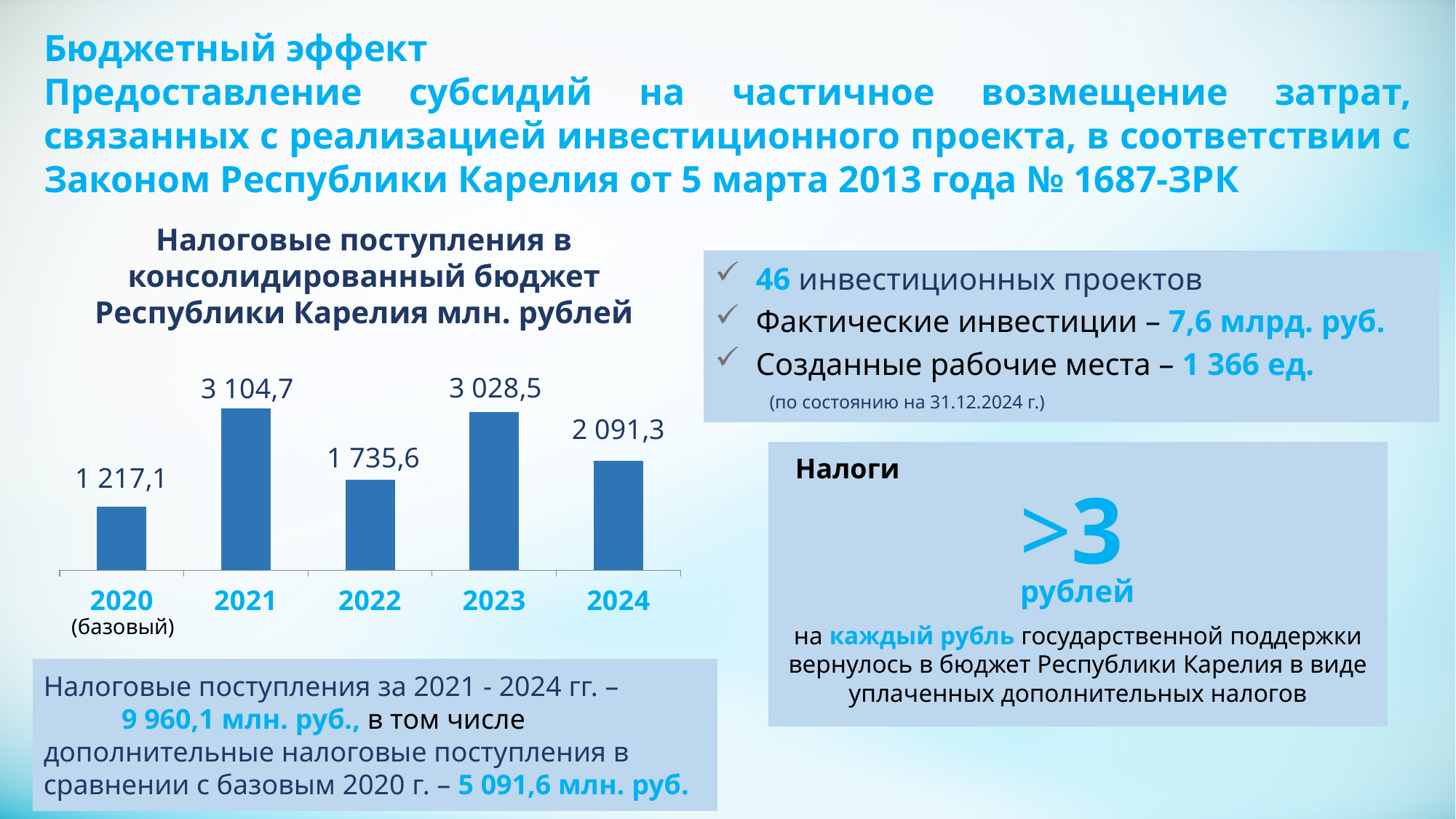
Which year has the highest value in the chart? 2021 What is the value for 2024 in the chart? 2 091,3 Which is larger, the value for 2022 or the value for 2024? 2024 Which year has the lowest value in the chart? 2020 What is the difference between the values for 2023 and 2022? 1 292,9 How many years are shown in the chart? 5 Does the value rise or fall from 2021 to 2022? Fall What is the value for 2023 in the chart? 3 028,5 What is the value for 2020 in the chart of tax revenues to the consolidated budget of the Republic of Karelia? 1 217,1 What kind of chart is shown on the slide? Bar chart In what units are the values in the chart expressed, according to its title? млн. рублей What is the difference between the values for 2021 and 2020? 1 887,6